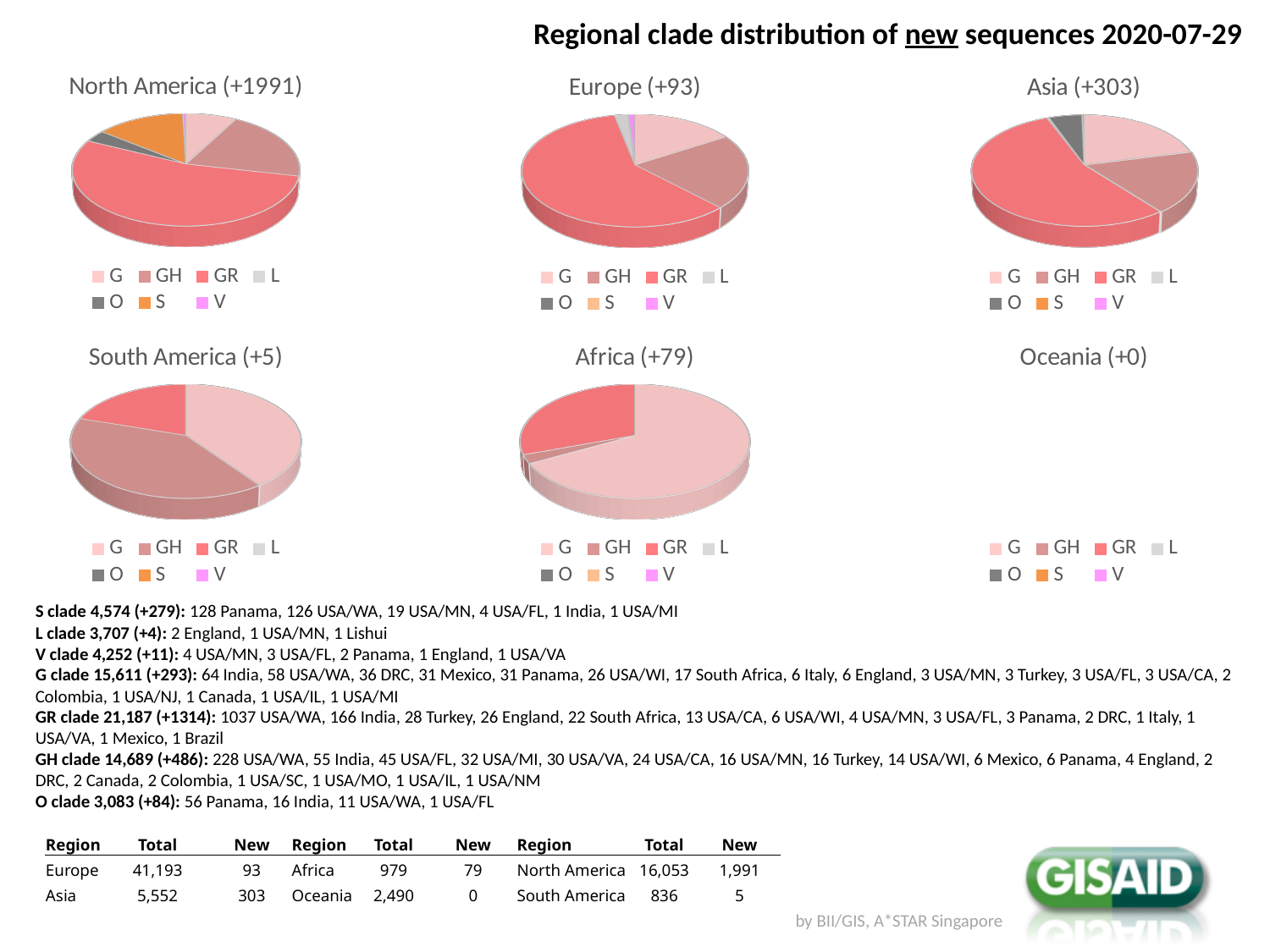
In the Asia (+303) chart, which slice is larger, GH or O? GH How many new sequences does the title of the Asia chart report? +303 In the Africa (+79) chart, which clade has the largest slice? G How many regional pie chart panels are shown on the slide? 6 In the North America (+1991) chart, which clade has the largest slice? GR What kind of chart is used for the North America (+1991) chart? pie chart In the Europe (+93) chart, which clade has the largest slice? GR In the Europe (+93) chart, which slice is larger, GR or G? GR In the Africa (+79) chart, which slice is larger, G or GR? G Which region's chart shows no data (zero new sequences)? Oceania (+0) How many entries does the legend of the Europe (+93) chart list? 7